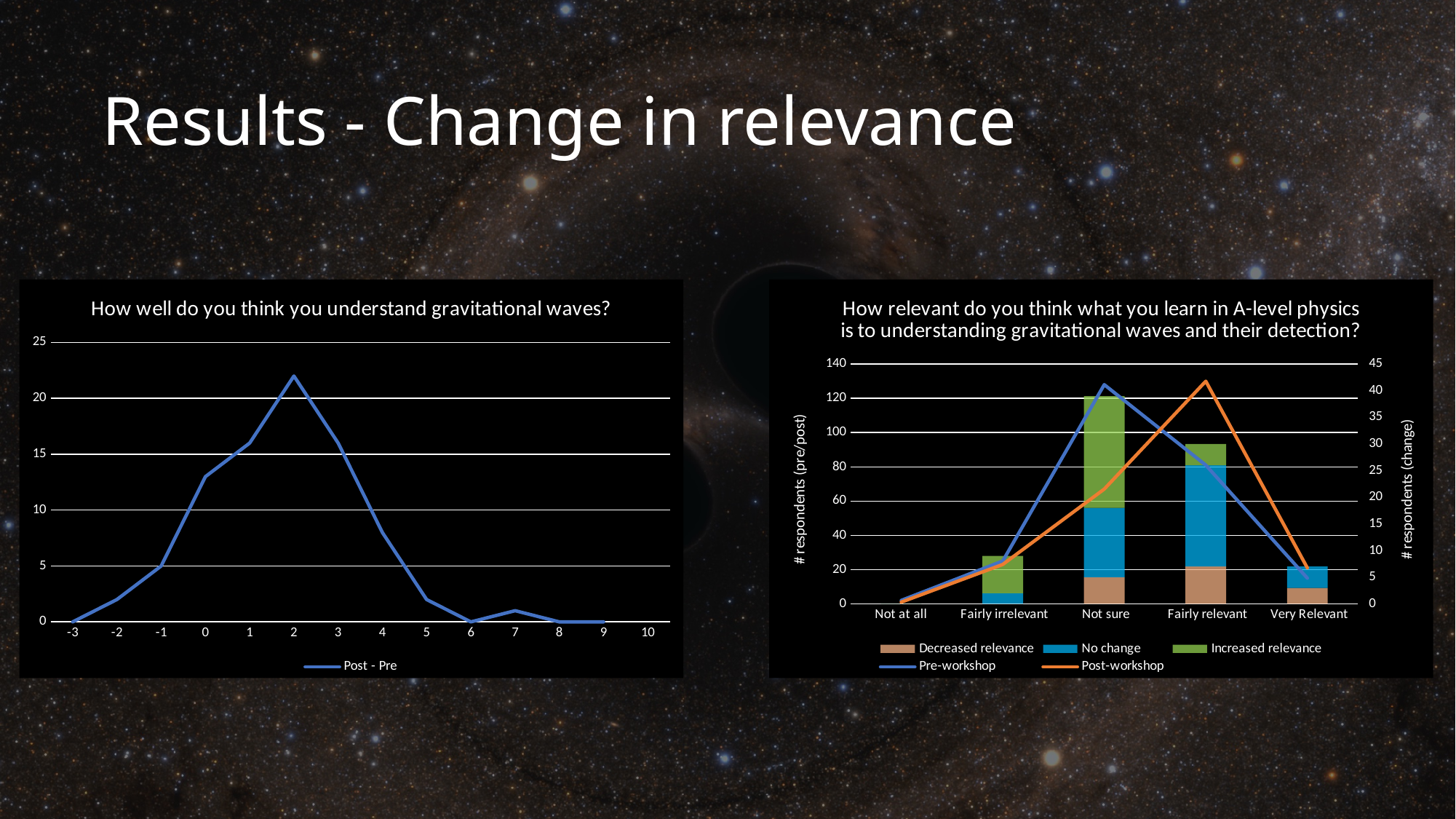
In the right chart, 'How relevant do you think what you learn in A-level physics...', at which category does the Post-workshop line reach its highest point? Fairly relevant In the right chart, 'How relevant do you think what you learn in A-level physics...', which category has the tallest stacked bar? Not sure How many series does the legend of the right chart, 'How relevant do you think what you learn in A-level physics is to understanding gravitational waves and their detection?', list? 5 What kind of chart is the left chart, 'How well do you think you understand gravitational waves?'? line chart In the left chart, 'How well do you think you understand gravitational waves?', is the Post - Pre value at x = 2 greater or less than 20? greater In the left chart, 'How well do you think you understand gravitational waves?', is the Post - Pre value at x = 5 greater or less than 5? less What is the label of the left vertical axis of the right chart, 'How relevant do you think what you learn in A-level physics...'? # respondents (pre/post) How many x-axis values are shown on the left chart, 'How well do you think you understand gravitational waves?'? 14 How many series does the legend of the left chart, 'How well do you think you understand gravitational waves?', list? 1 In the right chart, 'How relevant do you think what you learn in A-level physics...', at which category does the Pre-workshop line reach its highest point? Not sure